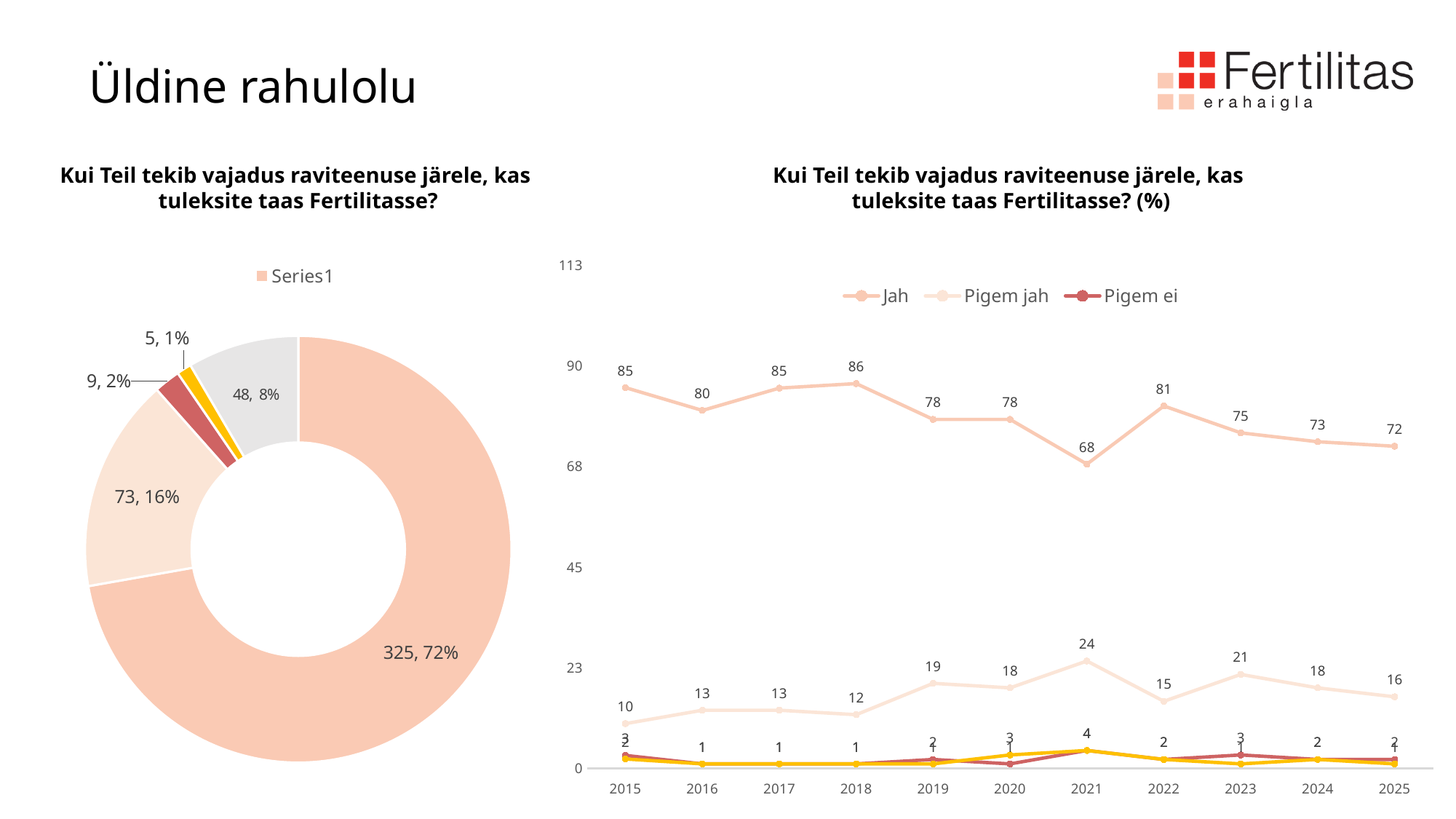
In the right line chart, what is the value of Jah in 2018? 86 In the right line chart, in which year is the Pigem jah value highest? 2021 In the right line chart, how many years are shown on the x axis? 11 In the left pie chart, what share of the total does the slice with value 73 represent? 16% In the left pie chart, what is the label on the largest slice? 325, 72% What kind of chart is the right chart, titled "Kui Teil tekib vajadus raviteenuse järele, kas tuleksite taas Fertilitasse? (%)"? line chart What kind of chart is the left chart, titled "Kui Teil tekib vajadus raviteenuse järele, kas tuleksite taas Fertilitasse?"? doughnut chart In the right line chart, how many series does the legend list? 3 In the right line chart, in which year is the Jah value lowest? 2021 In the right line chart, what is the value of Pigem jah in 2021? 24 In the right line chart, is the Jah value higher in 2022 or in 2023? 2022 In the right line chart, what is the difference between the Jah value in 2015 and in 2025? 13